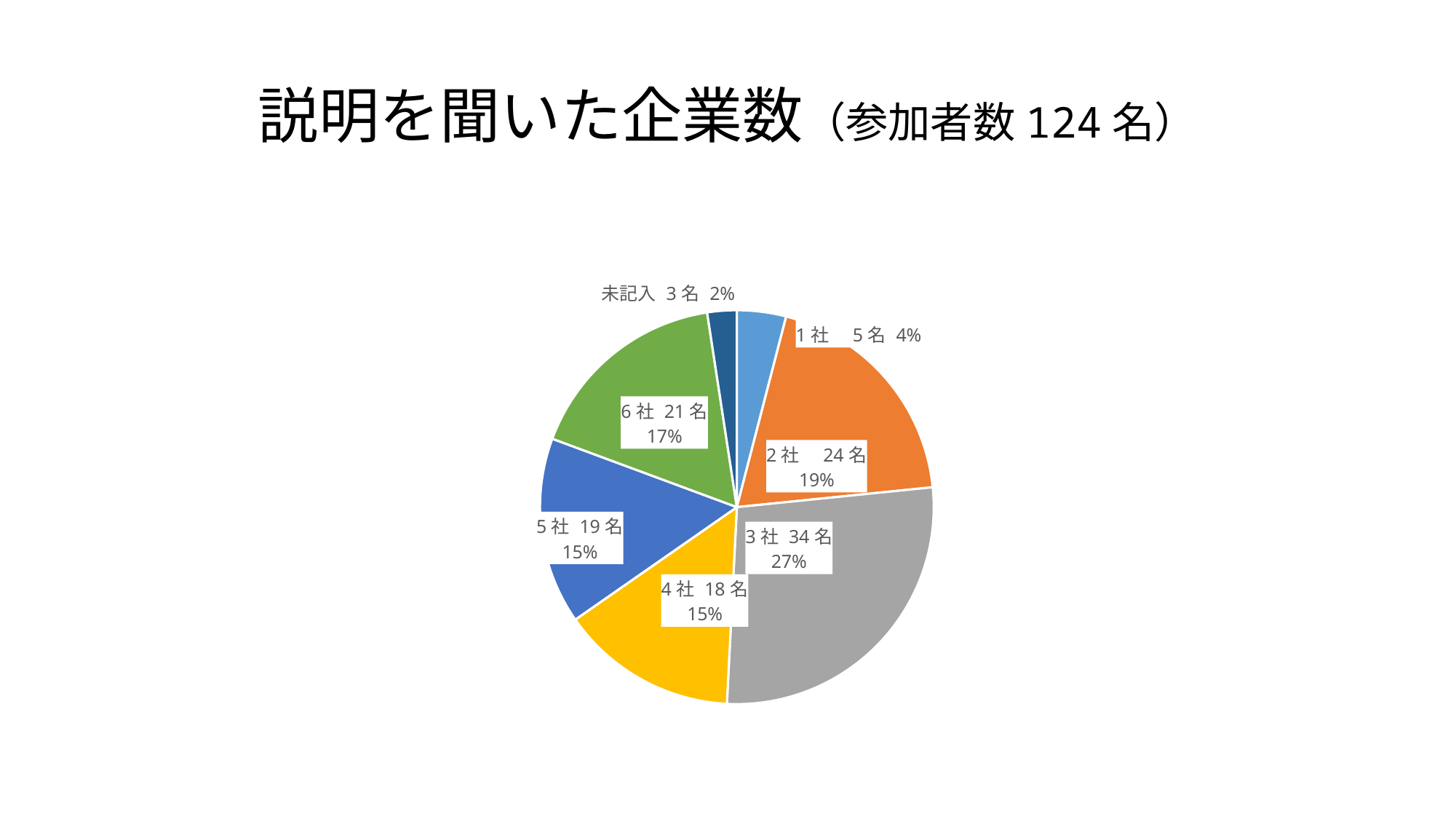
Which is larger, the number of people for 6社 or for 5社? 6社 What colour is the 3社 slice? grey How many slices does the pie chart have? 7 Which category has the smallest slice of the pie? 未記入 How many people are in the 未記入 category? 3名 What percentage share does the 1社 slice have? 4% What is the title of the chart on the slide? 説明を聞いた企業数（参加者数 124 名） What percentage share does the 2社 slice have? 19% What is the difference in number of people between 3社 and 2社? 10名 What kind of chart is shown on the slide? pie chart Which category has the largest slice of the pie? 3社 How many people heard explanations from 3 companies (3社)? 34名